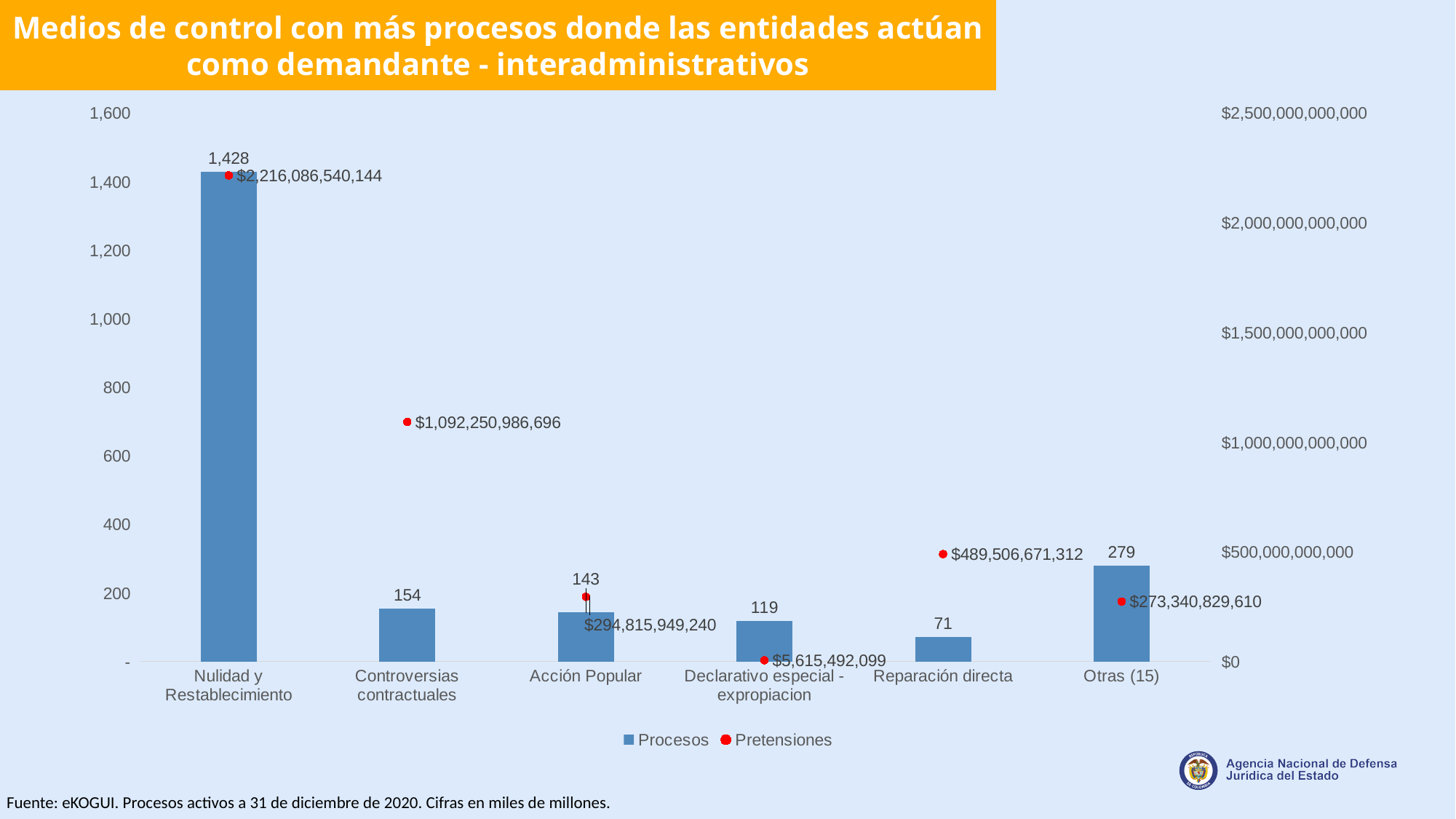
Which category has the highest number of Procesos? Nulidad y Restablecimiento What is the Pretensiones value for Controversias contractuales? $1,092,250,986,696 What is the difference in Procesos between Otras (15) and Controversias contractuales? 125 How many Procesos are shown for Reparación directa? 71 Which has more Procesos, Acción Popular or Declarativo especial - expropiacion? Acción Popular How many categories are shown on the x axis? 6 What is the source cited at the bottom of the slide? eKOGUI How many Procesos are shown for Nulidad y Restablecimiento? 1,428 How many series does the legend list? 2 Which category has the lowest number of Procesos? Reparación directa Which category has the lowest Pretensiones value? Declarativo especial - expropiacion What is the Pretensiones value for Declarativo especial - expropiacion? $5,615,492,099